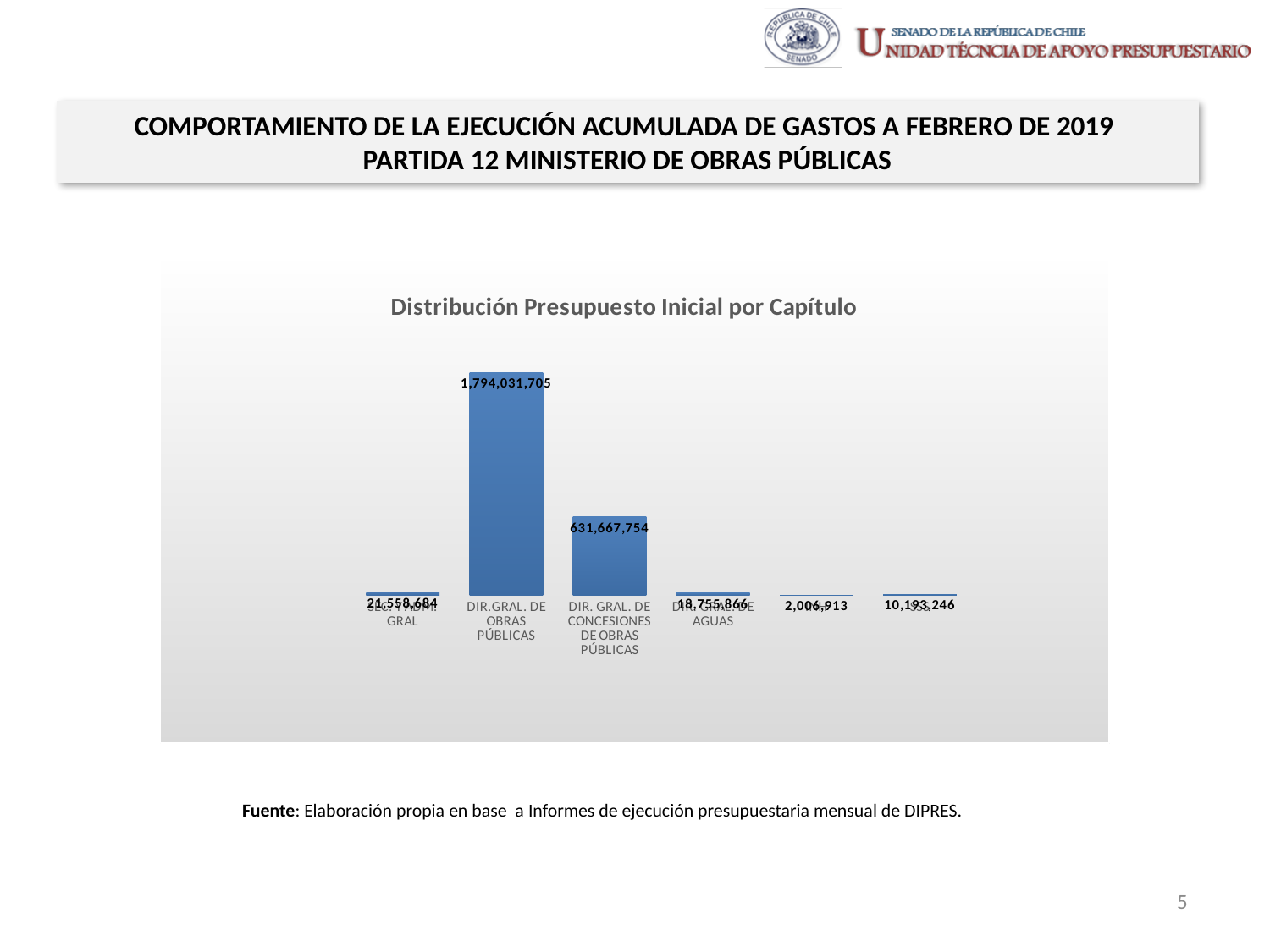
What is the difference between the rightmost bar (10,193,246) and the second bar from the right (2,006,913)? 8,186,333 Which category has the highest value in the chart? DIR.GRAL. DE OBRAS PÚBLICAS What is the difference between the values for DIR.GRAL. DE OBRAS PÚBLICAS and DIR. GRAL. DE CONCESIONES DE OBRAS PÚBLICAS? 1,162,363,951 What kind of chart is shown on the slide? Bar chart What is the title of the chart? Distribución Presupuesto Inicial por Capítulo Which is larger: the value for DIR.GRAL. DE OBRAS PÚBLICAS or the value for DIR. GRAL. DE CONCESIONES DE OBRAS PÚBLICAS? DIR.GRAL. DE OBRAS PÚBLICAS What is the value of the rightmost bar in the chart? 10,193,246 What is the value for DIR. GRAL. DE CONCESIONES DE OBRAS PÚBLICAS? 631,667,754 What is the smallest value shown in the chart? 2,006,913 What is the value for DIR.GRAL. DE OBRAS PÚBLICAS in the chart 'Distribución Presupuesto Inicial por Capítulo'? 1,794,031,705 How many bars are shown in the chart? 6 What is the value of the leftmost bar in the chart? 21,558,684